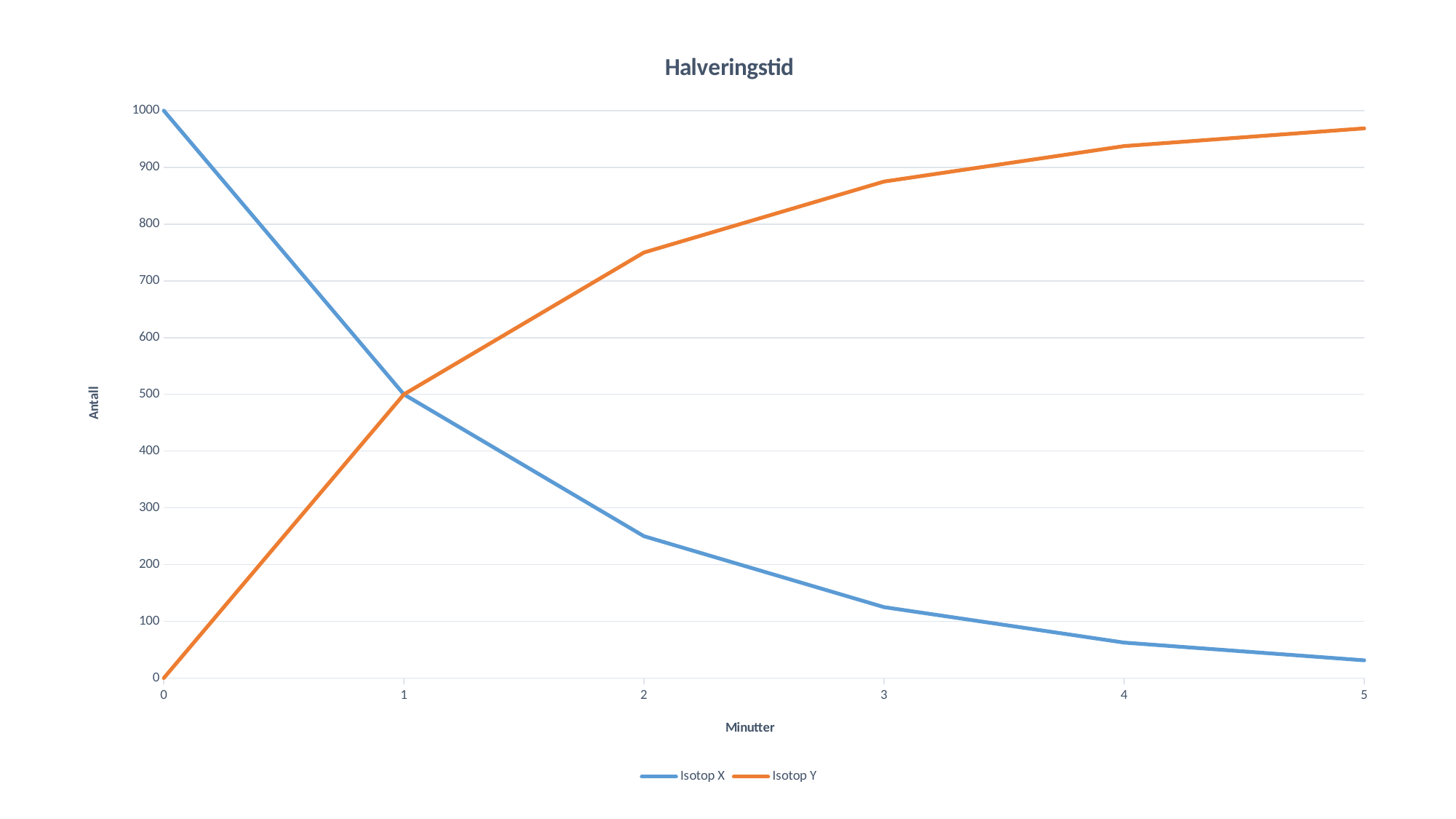
How many series does the legend list? 2 What is the value of Isotop Y at 0 minutes? 0 Is the value for Isotop X at 2 minutes greater or less than 300? less By how much does Isotop X decrease between 0 and 1 minute? 500 What kind of chart is shown on the slide? line chart What is the value of Isotop X at 1 minute? 500 At 3 minutes, which series has the higher value, Isotop X or Isotop Y? Isotop Y Is the value for Isotop Y at 3 minutes greater or less than 800? greater Does the Isotop X line rise or fall as the minutes increase? fall What is the value of Isotop X at 0 minutes? 1000 What is the value of Isotop Y at 1 minute? 500 What is the title of the chart? Halveringstid